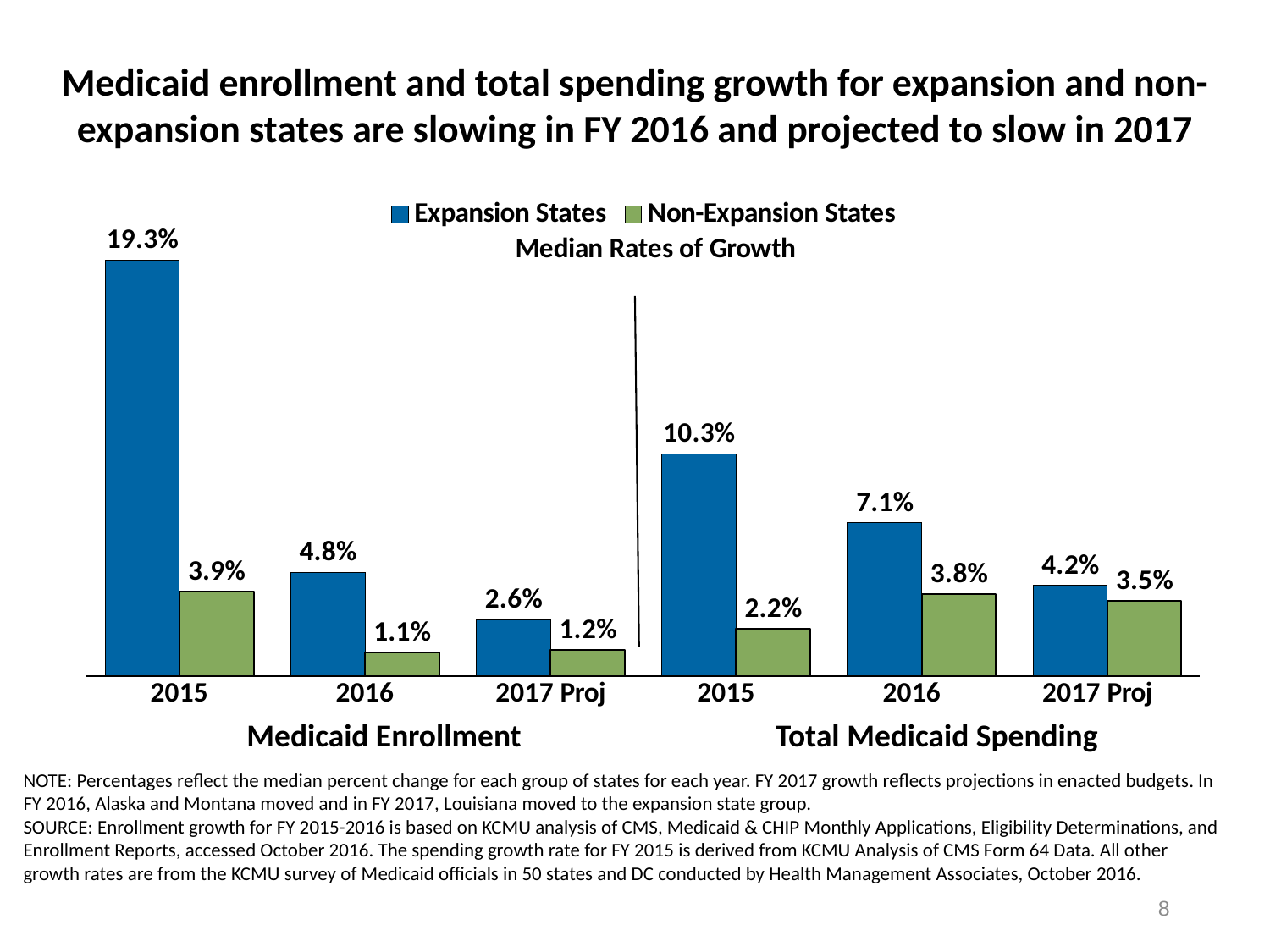
What is the Expansion States value for Medicaid Enrollment in 2015? 19.3% What kind of chart is shown on the slide? Bar chart Which is larger: the Expansion States value for Medicaid Enrollment in 2017 Proj or the Expansion States value for Total Medicaid Spending in 2017 Proj? Total Medicaid Spending 2017 Proj Do the Expansion States values for Total Medicaid Spending rise or fall from 2015 to 2017 Proj? Fall What colour represents Non-Expansion States in the chart? Green How many series does the legend list? 2 What is the Non-Expansion States value for Total Medicaid Spending in 2016? 3.8% Which category has the lowest Non-Expansion States value? Medicaid Enrollment 2016 What is the difference between the Expansion States and Non-Expansion States values for Total Medicaid Spending in 2015? 8.1% What is the Expansion States value for Total Medicaid Spending in 2017 Proj? 4.2% What is the Non-Expansion States value for Medicaid Enrollment in 2016? 1.1% Which category has the highest Expansion States value? Medicaid Enrollment 2015